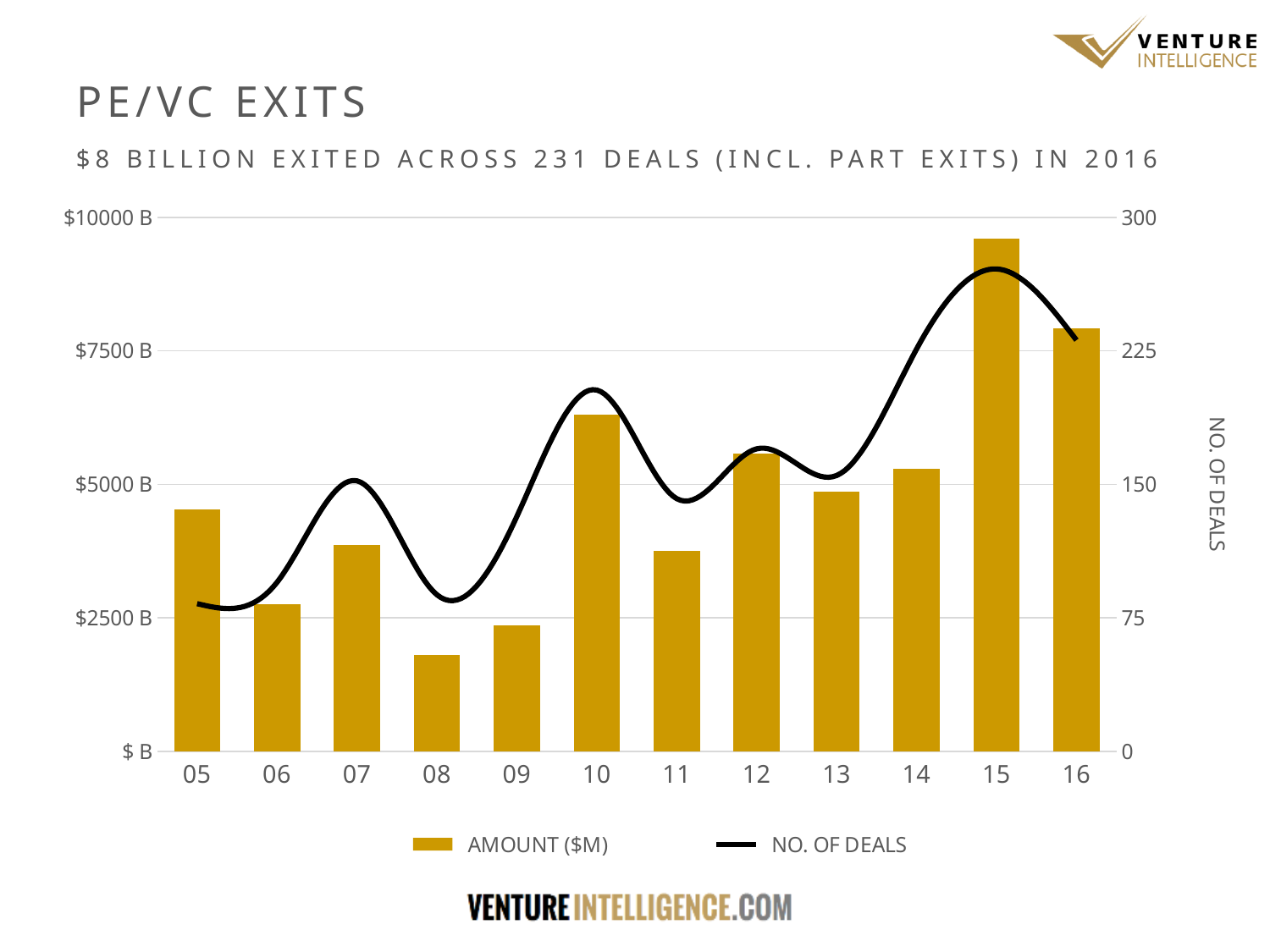
Which year has the lowest bar for AMOUNT ($M)? 08 Do the AMOUNT ($M) bars rise or fall from 13 to 15? rise What are the two series named in the legend? AMOUNT ($M) and NO. OF DEALS Which year has a larger AMOUNT ($M) bar, 10 or 11? 10 Which year has the highest bar for AMOUNT ($M)? 15 Which year has a larger AMOUNT ($M) bar, 15 or 16? 15 What kind of chart is shown on the slide? A combined bar and line chart How many series does the legend list? 2 Is the AMOUNT ($M) bar for 08 greater or less than $2500 B on the left axis? less Is the AMOUNT ($M) bar for 15 greater or less than $7500 B on the left axis? greater Is the NO. OF DEALS value for 15 greater or less than 225 on the right axis? greater How many years are shown on the x axis of the chart? 12